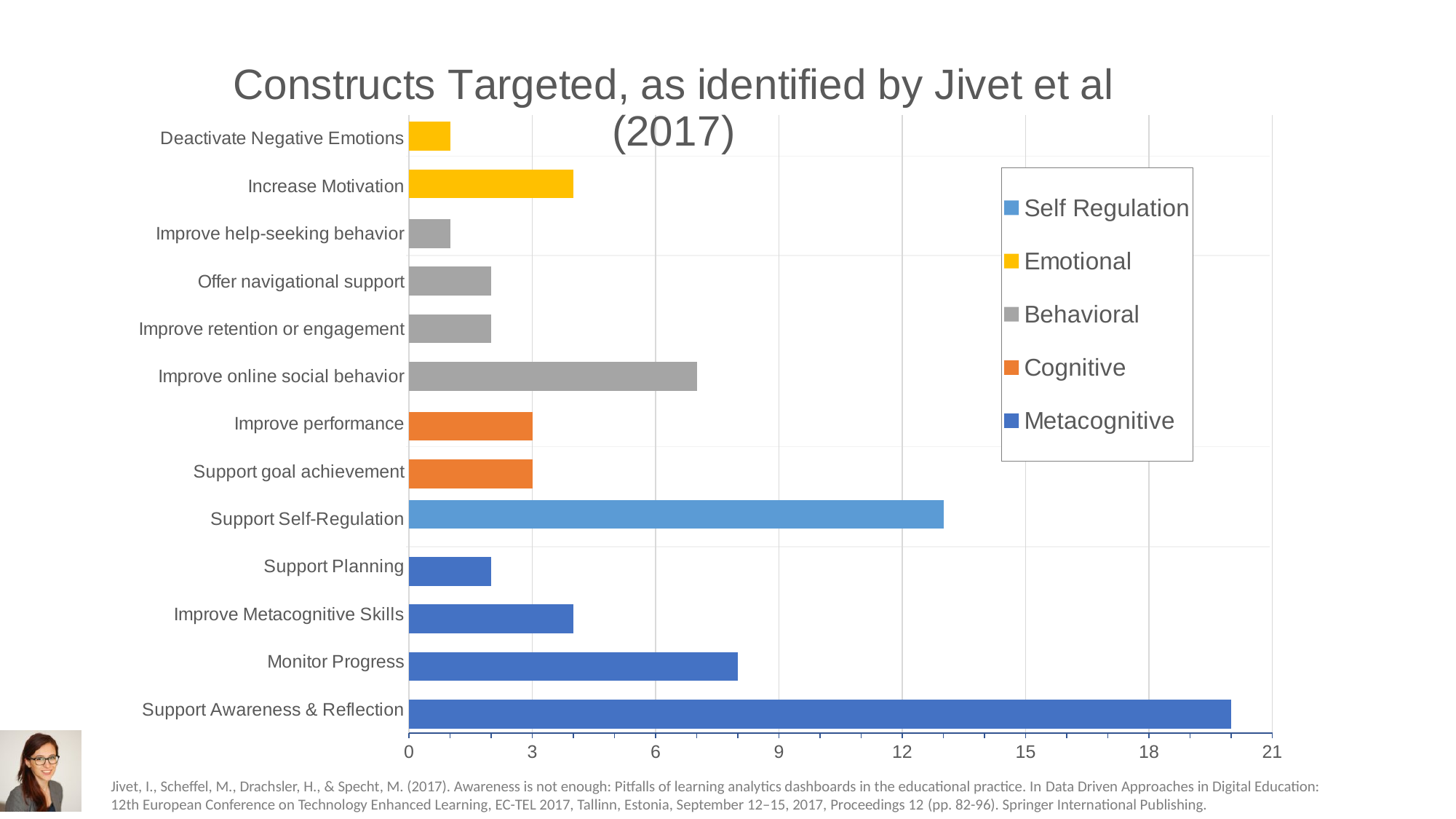
Is the value for Support Awareness & Reflection greater or less than 18? greater What is the value for Support goal achievement? 3 How many categories are plotted on the chart? 13 What is the title of the chart? Constructs Targeted, as identified by Jivet et al (2017) What is the value for Improve performance? 3 Is the value for Support Planning greater or less than 3? less Is the value for Support Self-Regulation greater or less than 12? greater Which is larger, the value for Support Self-Regulation or the value for Monitor Progress? Support Self-Regulation Which category has the highest value? Support Awareness & Reflection Which legend series is shown in yellow? Emotional What type of chart is shown on the slide? bar chart How many series does the legend list? 5